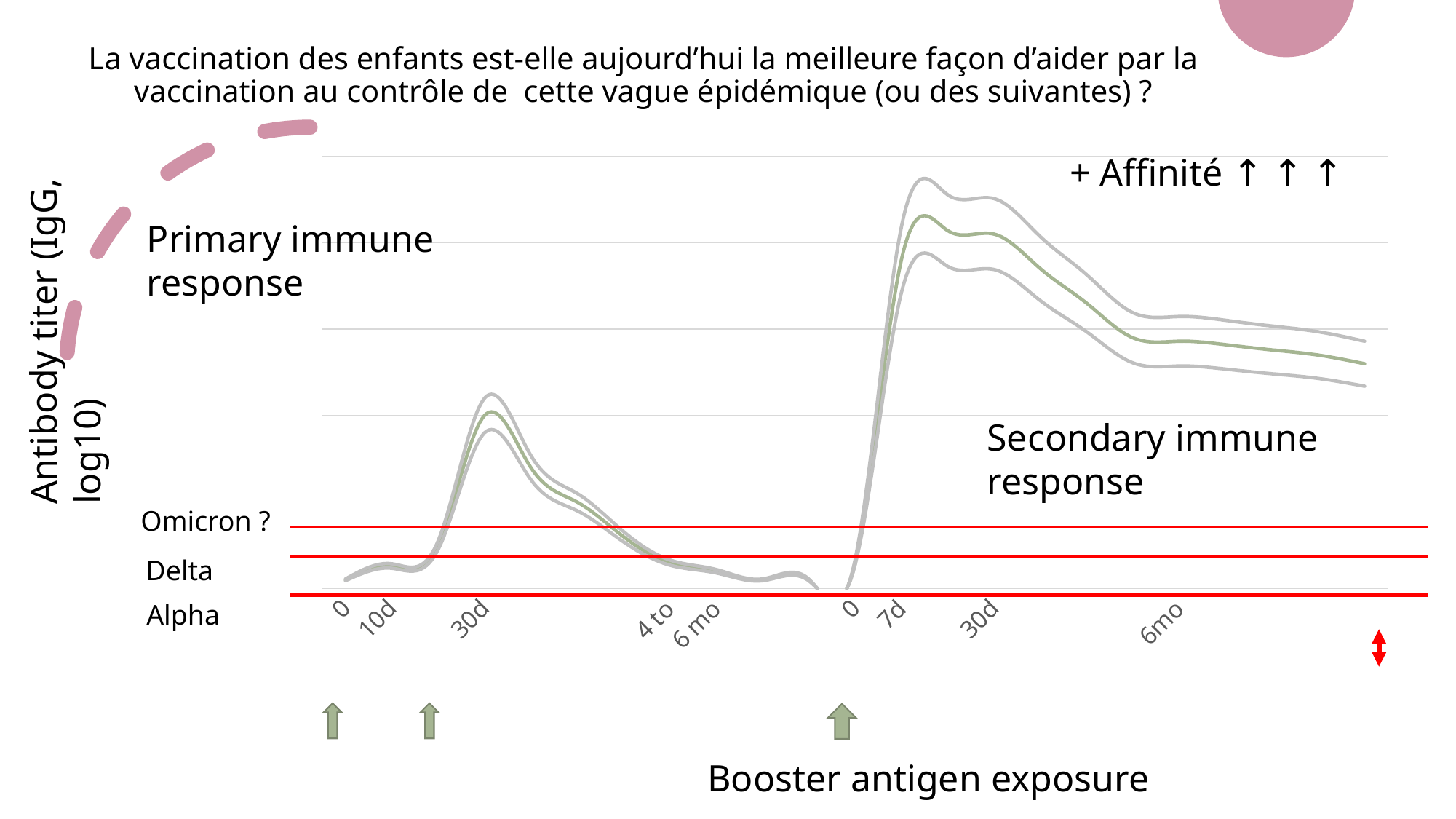
What is the label of the vertical axis? Antibody titer (IgG, log10) Which of the three red horizontal threshold lines is the lowest on the chart? Alpha Does the antibody titer rise or fall between 0 and 7d in the secondary immune response? Rise Is the peak of the primary immune response above or below the Omicron ? line? Above What kind of chart is shown on the slide? Line chart Does the antibody titer rise or fall between 30d and 4 to 6 mo in the primary immune response? Fall Does the antibody titer rise or fall between 30d and 6mo in the secondary immune response? Fall Which is higher, the peak of the primary immune response or the peak of the secondary immune response? Secondary immune response Which of the three red horizontal threshold lines is the highest on the chart? Omicron ? How many tick labels are shown along the x axis? 9 What text labels the green arrows below the x axis? Booster antigen exposure